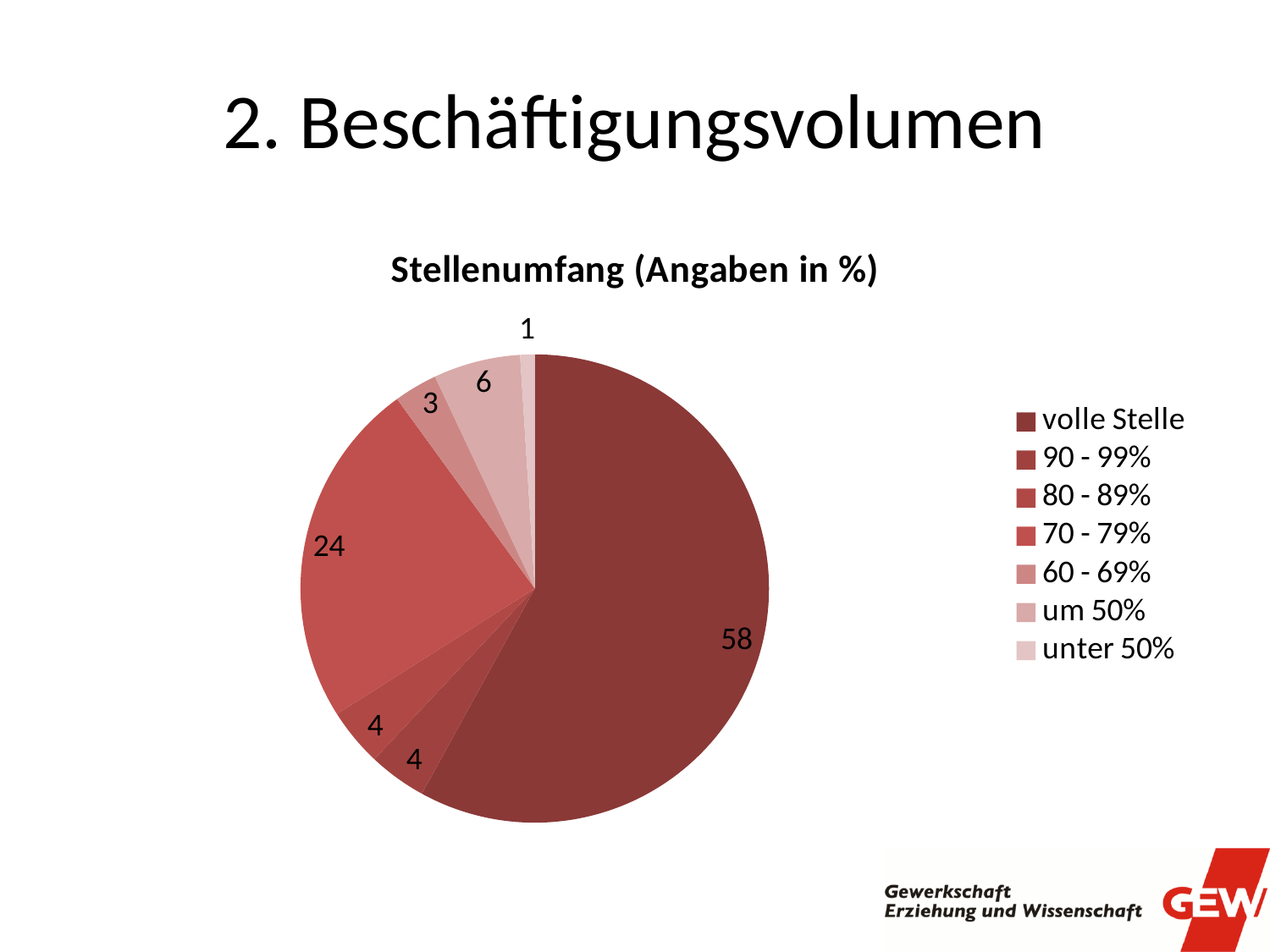
Which is larger, the value for "um 50%" or the value for "60 - 69%"? um 50% What is the value for "70 - 79%"? 24 What kind of chart is shown on the slide? pie chart What is the value for "60 - 69%"? 3 What is the title of the chart? Stellenumfang (Angaben in %) What is the value for "um 50%"? 6 Which category has the smallest slice? unter 50% What is the difference between the values for "volle Stelle" and "70 - 79%"? 34 What is the value for "volle Stelle"? 58 What is the value for "unter 50%"? 1 How many categories does the legend list? 7 Which category has the largest slice? volle Stelle